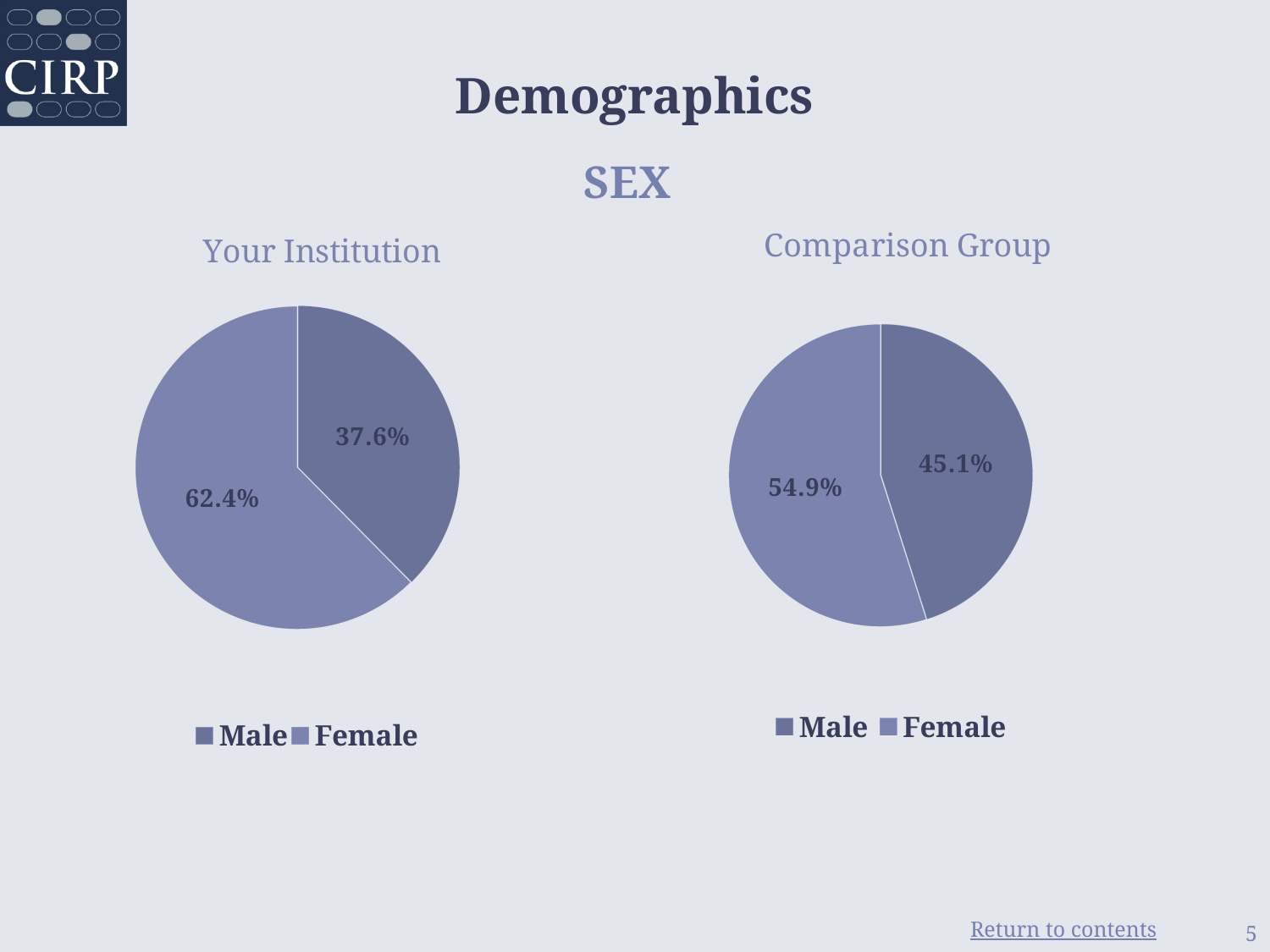
In the 'Your Institution' chart, what percentage is Male? 37.6% How many categories does the 'Comparison Group' chart show? 2 In the 'Comparison Group' chart, what percentage is Female? 54.9% What type of chart is the 'Your Institution' chart? Pie chart In the 'Your Institution' chart, which category has the largest share? Female In the 'Comparison Group' chart, what percentage is Male? 45.1% In the 'Comparison Group' chart, what is the difference between the Female and Male percentages? 9.8% Is the Male share larger in the 'Your Institution' chart or the 'Comparison Group' chart? Comparison Group In the 'Your Institution' chart, what percentage is Female? 62.4% What are the legend entries in the 'Your Institution' chart? Male, Female In the 'Your Institution' chart, what is the difference between the Female and Male percentages? 24.8% In the 'Comparison Group' chart, which category has the smallest share? Male